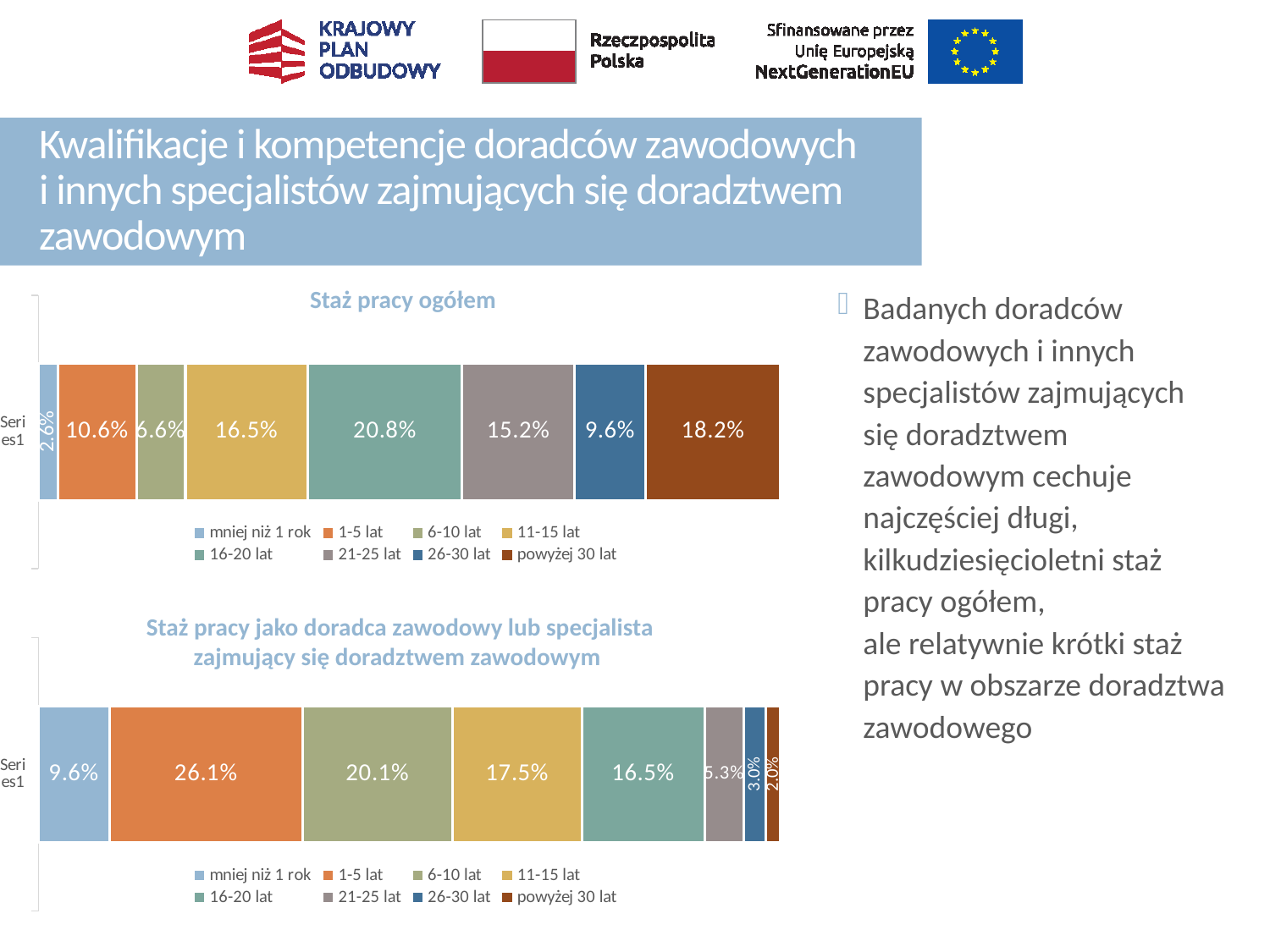
In the chart titled "Staż pracy ogółem", what is the value for the "16-20 lat" segment? 20.8% How many entries does the legend of the chart titled "Staż pracy ogółem" list? 8 In the chart titled "Staż pracy ogółem", which segment has the highest value? 16-20 lat In the bottom chart (Staż pracy jako doradca zawodowy lub specjalista zajmujący się doradztwem zawodowym), what is the value for the "21-25 lat" segment? 5.3% In the bottom chart (Staż pracy jako doradca zawodowy lub specjalista zajmujący się doradztwem zawodowym), which is larger: "6-10 lat" or "11-15 lat"? 6-10 lat What type of chart is the chart titled "Staż pracy ogółem"? Stacked bar chart In the bottom chart (Staż pracy jako doradca zawodowy lub specjalista zajmujący się doradztwem zawodowym), what is the value for the "1-5 lat" segment? 26.1% In the bottom chart (Staż pracy jako doradca zawodowy lub specjalista zajmujący się doradztwem zawodowym), which segment has the lowest value? powyżej 30 lat In the chart titled "Staż pracy ogółem", which segment has the lowest value? mniej niż 1 rok In the bottom chart (Staż pracy jako doradca zawodowy lub specjalista zajmujący się doradztwem zawodowym), what is the difference between the "1-5 lat" and "mniej niż 1 rok" values? 16.5% In the chart titled "Staż pracy ogółem", what is the difference between the "11-15 lat" and "6-10 lat" values? 9.9% In the chart titled "Staż pracy ogółem", what is the value for the "powyżej 30 lat" segment? 18.2%